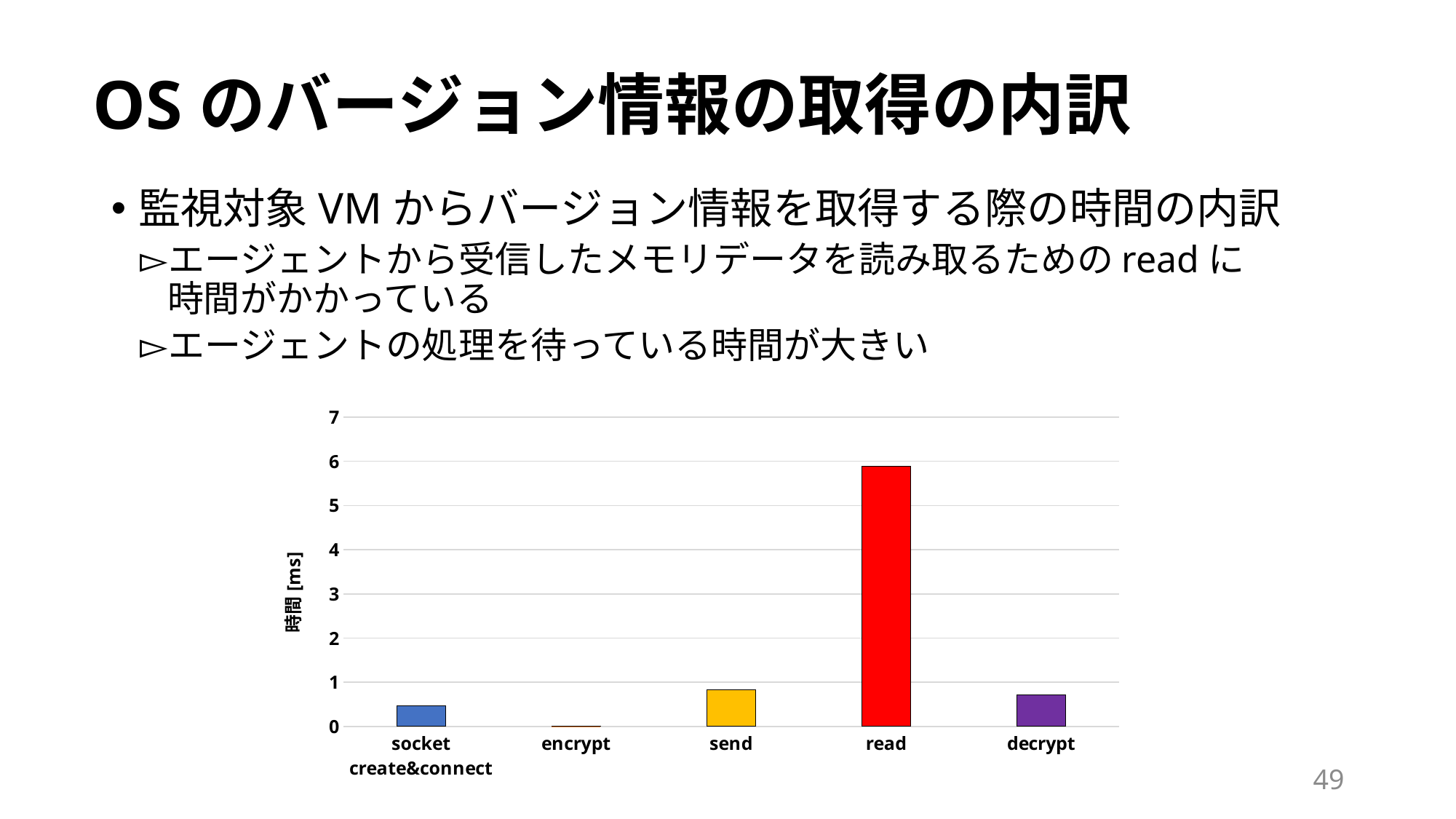
Which is larger, the value for read or the value for send? read Which is larger, the value for send or the value for socket create&connect? send Is the value for read greater or less than 6? less How many categories are shown on the x axis of the chart? 5 Which category has the highest value in the chart? read Which category has the lowest value in the chart? encrypt Is the value for send greater or less than 1? less What is the label of the y axis of the chart? 時間 [ms] Is the value for read greater or less than 5? greater Which is larger, the value for decrypt or the value for encrypt? decrypt What kind of chart is shown on the slide? bar chart